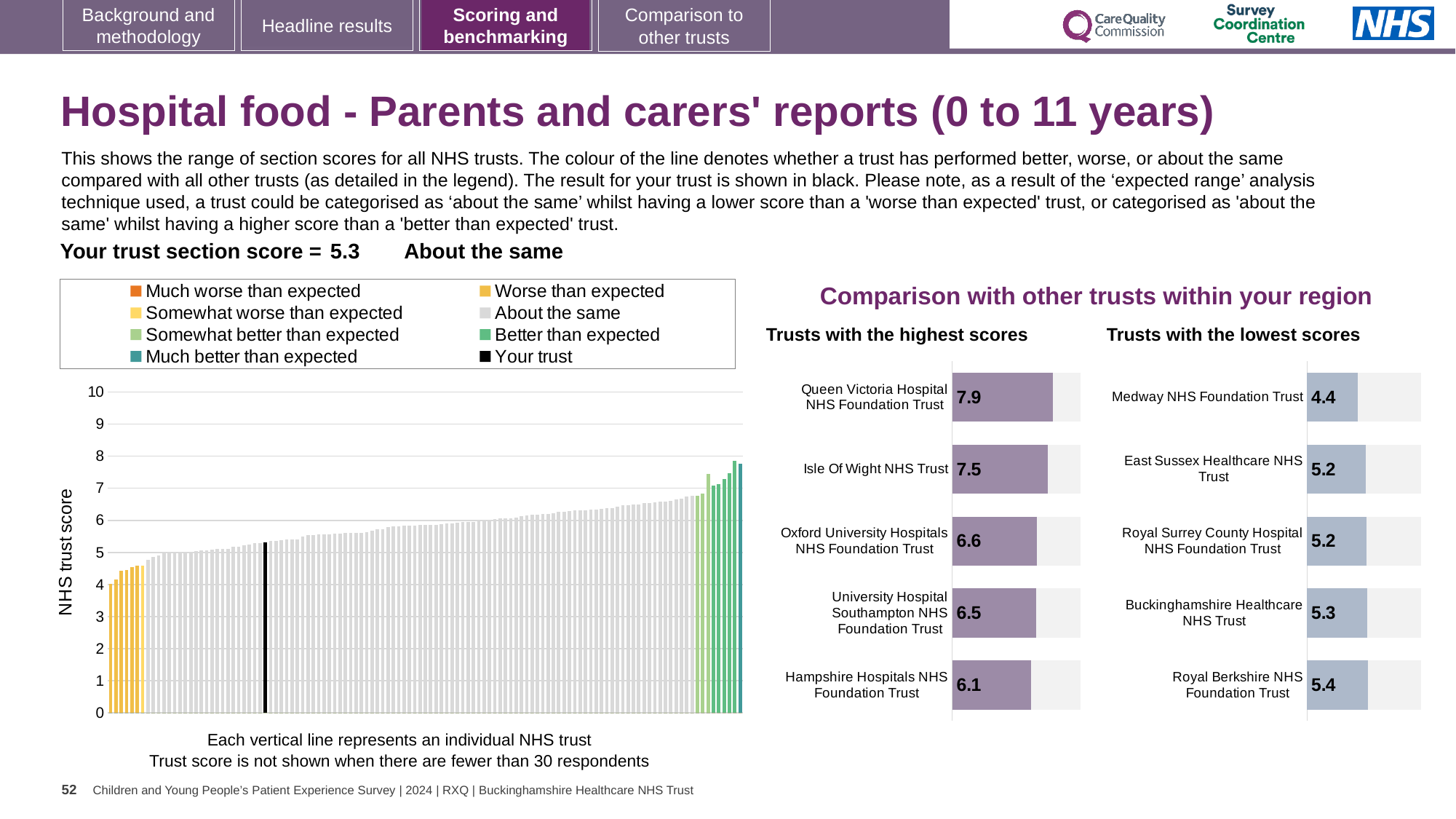
In the 'Trusts with the highest scores' chart, what is the difference between the scores of Queen Victoria Hospital NHS Foundation Trust and Isle Of Wight NHS Trust? 0.4 How many trusts are shown in the 'Trusts with the highest scores' chart? 5 In the 'NHS trust score' chart on the left, do the values rise or fall from left to right? Rise In the 'Trusts with the highest scores' chart, what is the score for Hampshire Hospitals NHS Foundation Trust? 6.1 In the 'Trusts with the lowest scores' chart, what is the score for Royal Berkshire NHS Foundation Trust? 5.4 In the 'Trusts with the lowest scores' chart, which is larger: the score for Medway NHS Foundation Trust or Buckinghamshire Healthcare NHS Trust? Buckinghamshire Healthcare NHS Trust In the 'Trusts with the lowest scores' chart, what is the difference between the scores of Royal Berkshire NHS Foundation Trust and Medway NHS Foundation Trust? 1.0 What kind of chart is the 'NHS trust score' chart on the left of the slide? Bar chart How many entries does the legend above the 'NHS trust score' chart list? 8 In the 'Trusts with the lowest scores' chart, which trust has the lowest score? Medway NHS Foundation Trust In the 'Trusts with the highest scores' chart, what is the score for Queen Victoria Hospital NHS Foundation Trust? 7.9 In the 'NHS trust score' chart on the left, is the value of the tallest bar greater or less than 7? greater